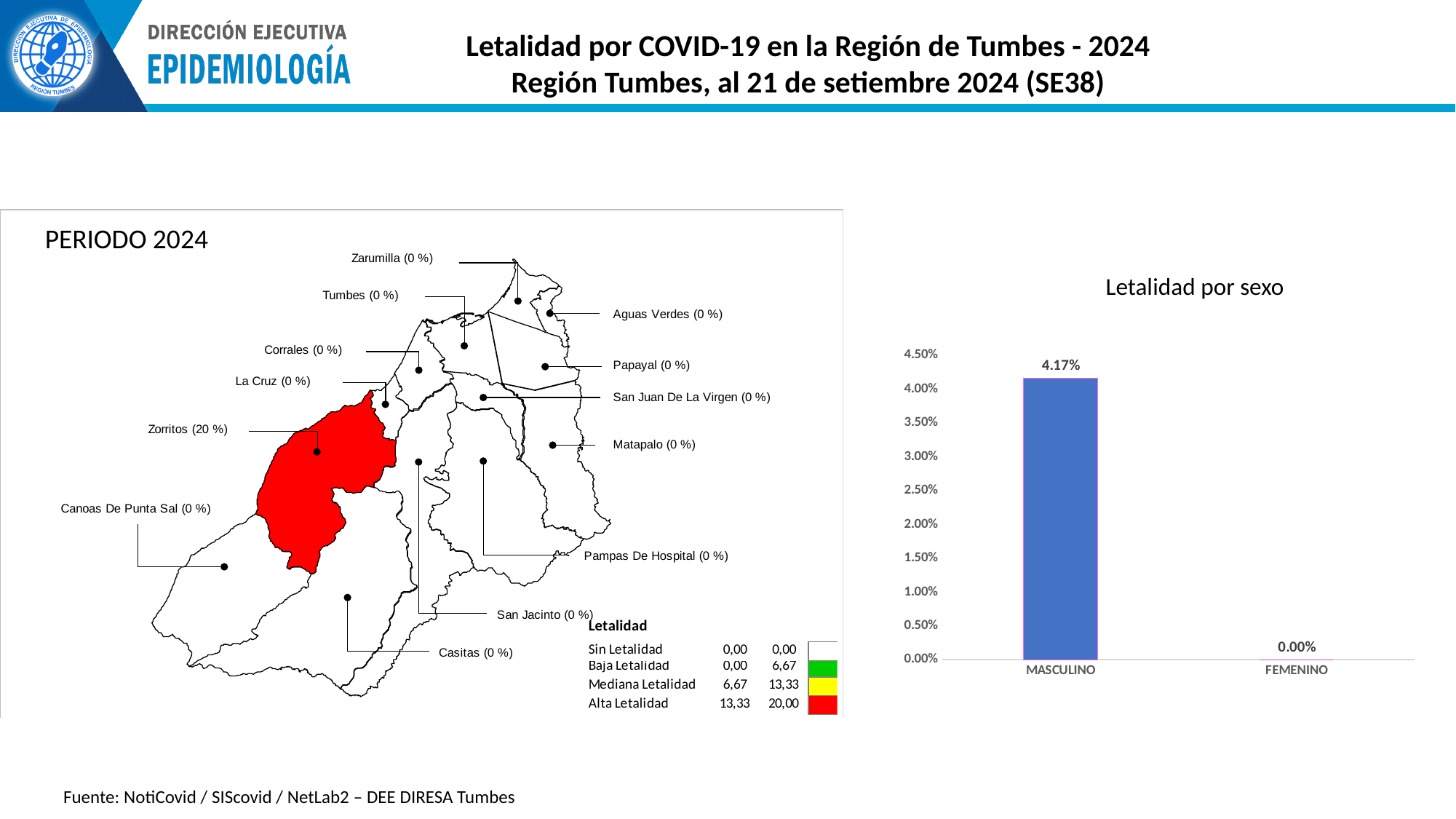
In the 'Letalidad por sexo' chart, which is larger, the value for MASCULINO or for FEMENINO? MASCULINO How many categories are shown in the 'Letalidad por sexo' chart? 2 In the 'Letalidad por sexo' chart, what is the difference between the MASCULINO and FEMENINO values? 4.17% What kind of chart is the 'Letalidad por sexo' chart? bar chart In the 'Letalidad por sexo' chart, which category has the lowest value? FEMENINO What is the title of the chart on the right side of the slide? Letalidad por sexo What is the highest value shown on the vertical axis of the 'Letalidad por sexo' chart? 4.50% In the 'Letalidad por sexo' chart, is the value for MASCULINO greater or less than 4.00%? greater In the 'Letalidad por sexo' chart, what is the value for MASCULINO? 4.17% On the map 'PERIODO 2024', what is the lethality value shown for Zorritos? 20 % In the 'Letalidad por sexo' chart, what is the value for FEMENINO? 0.00% In the 'Letalidad por sexo' chart, which category has the highest value? MASCULINO